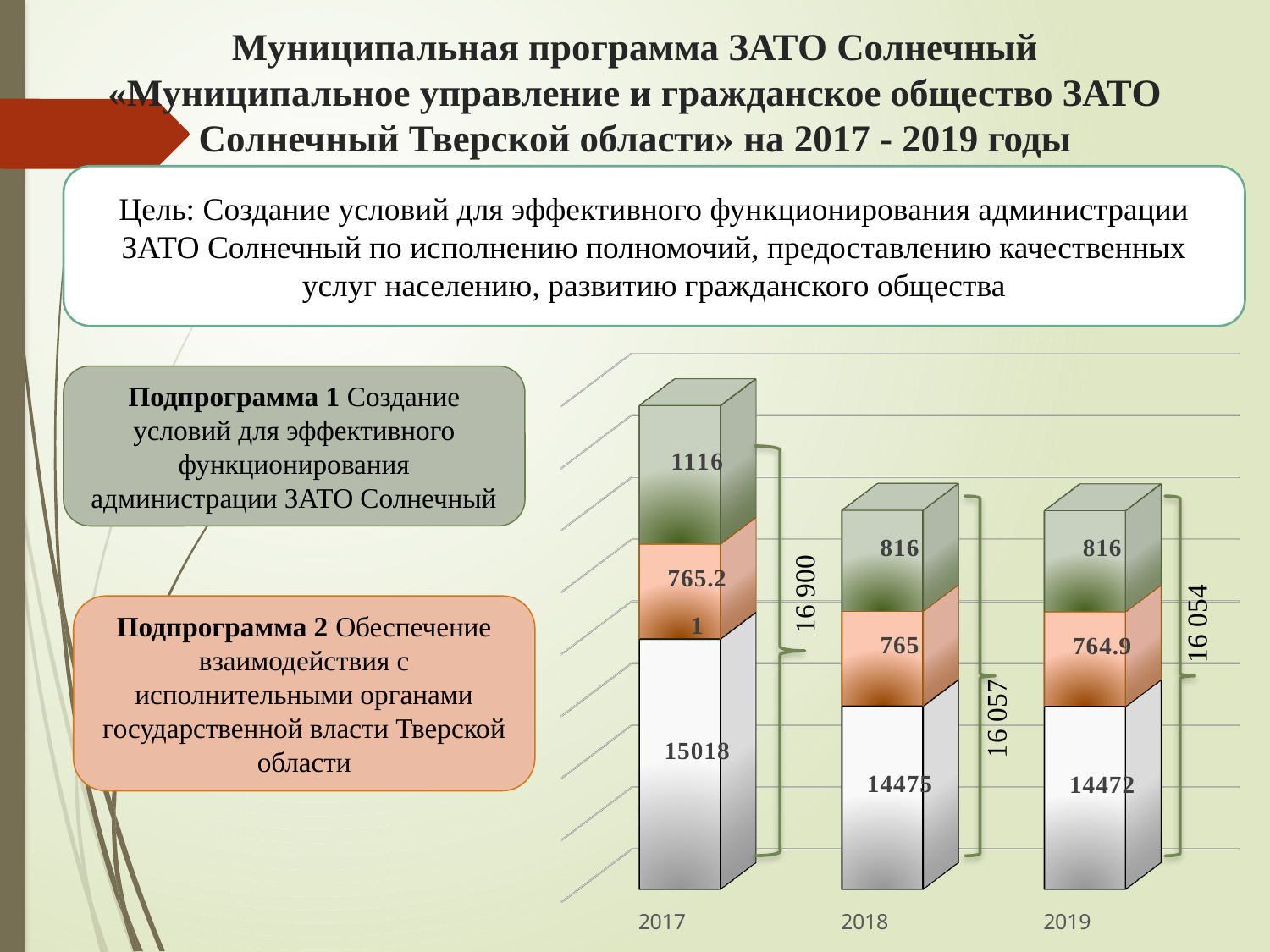
What kind of chart is shown on the slide? stacked bar chart Which year has the highest total value? 2017 What is the value of the top (green) segment of the 2018 bar? 816 What is the difference between the top (green) segment values for 2017 and 2018? 300 Do the bar totals rise or fall from 2017 to 2019? fall What is the value of the middle (orange) segment of the 2019 bar? 764.9 What total is shown by the bracket next to the 2019 bar? 16 054 What total is shown by the bracket next to the 2017 bar? 16 900 How many years are shown on the x axis of the chart? 3 What is the value of the bottom (white) segment of the 2017 bar? 15018 Which is larger, the top (green) segment for 2017 or for 2019? 2017 What is the difference between the bottom segment values for 2017 and 2018? 543